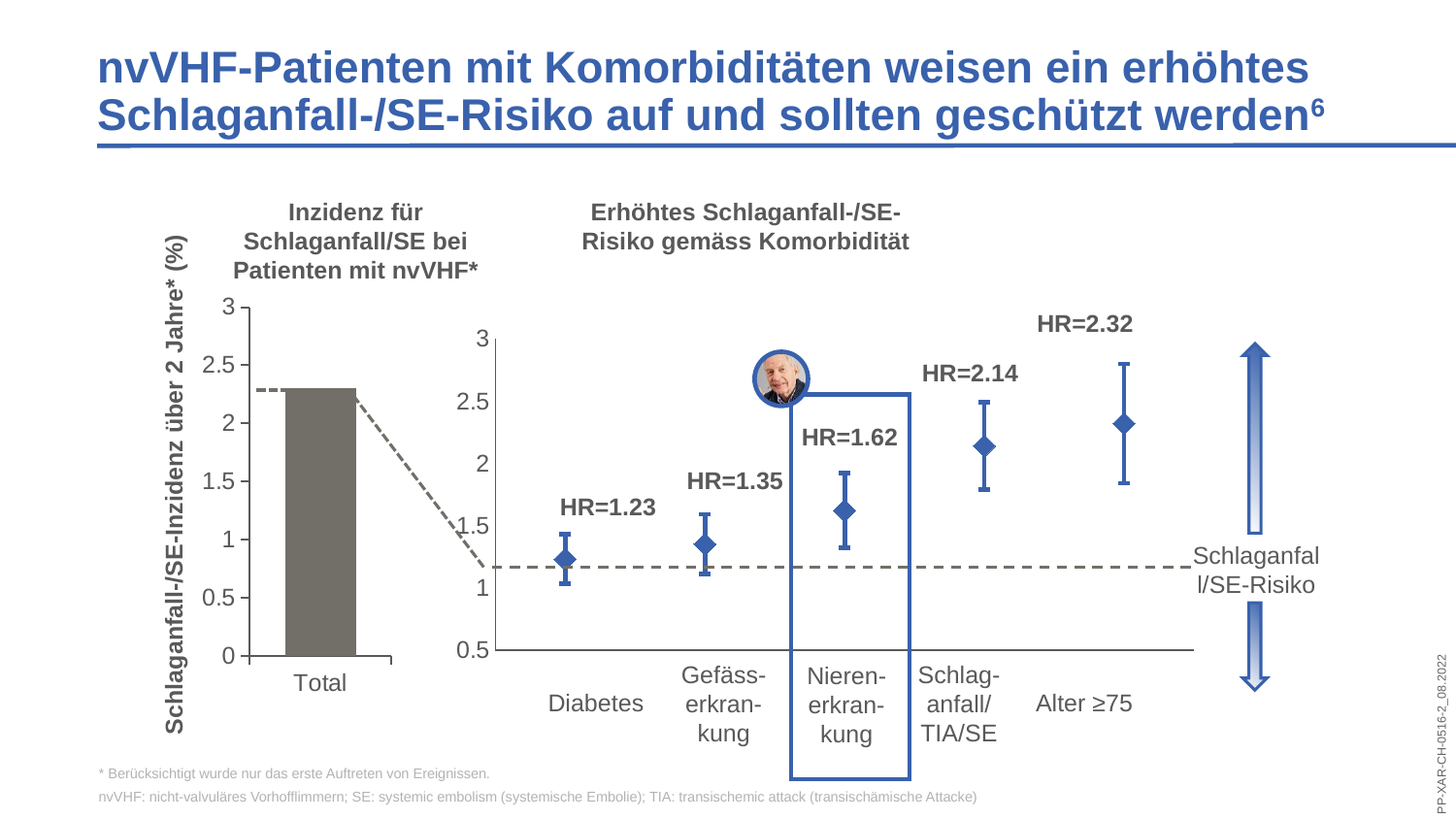
In the chart 'Erhöhtes Schlaganfall-/SE-Risiko gemäss Komorbidität', what is the HR value for Alter ≥75? HR=2.32 In the chart 'Erhöhtes Schlaganfall-/SE-Risiko gemäss Komorbidität', which has a higher HR: Gefässerkrankung or Schlaganfall/TIA/SE? Schlaganfall/TIA/SE In the chart 'Erhöhtes Schlaganfall-/SE-Risiko gemäss Komorbidität', what is the HR value for Nierenerkrankung? HR=1.62 In the chart 'Erhöhtes Schlaganfall-/SE-Risiko gemäss Komorbidität', what is the HR value for Diabetes? HR=1.23 In the chart 'Erhöhtes Schlaganfall-/SE-Risiko gemäss Komorbidität', do the HR values rise or fall from left to right? rise In the chart 'Erhöhtes Schlaganfall-/SE-Risiko gemäss Komorbidität', what is the difference between the HR for Schlaganfall/TIA/SE and the HR for Nierenerkrankung? 0.52 How many comorbidity categories are shown in the chart 'Erhöhtes Schlaganfall-/SE-Risiko gemäss Komorbidität'? 5 What kind of chart is the left chart 'Inzidenz für Schlaganfall/SE bei Patienten mit nvVHF*'? bar chart In the chart 'Erhöhtes Schlaganfall-/SE-Risiko gemäss Komorbidität', which comorbidity has the lowest HR? Diabetes In the chart 'Erhöhtes Schlaganfall-/SE-Risiko gemäss Komorbidität', which comorbidity has the highest HR? Alter ≥75 In the left chart 'Inzidenz für Schlaganfall/SE bei Patienten mit nvVHF*', is the value for Total greater or less than 2? greater In the chart 'Erhöhtes Schlaganfall-/SE-Risiko gemäss Komorbidität', what is the difference between the HR for Alter ≥75 and the HR for Diabetes? 1.09